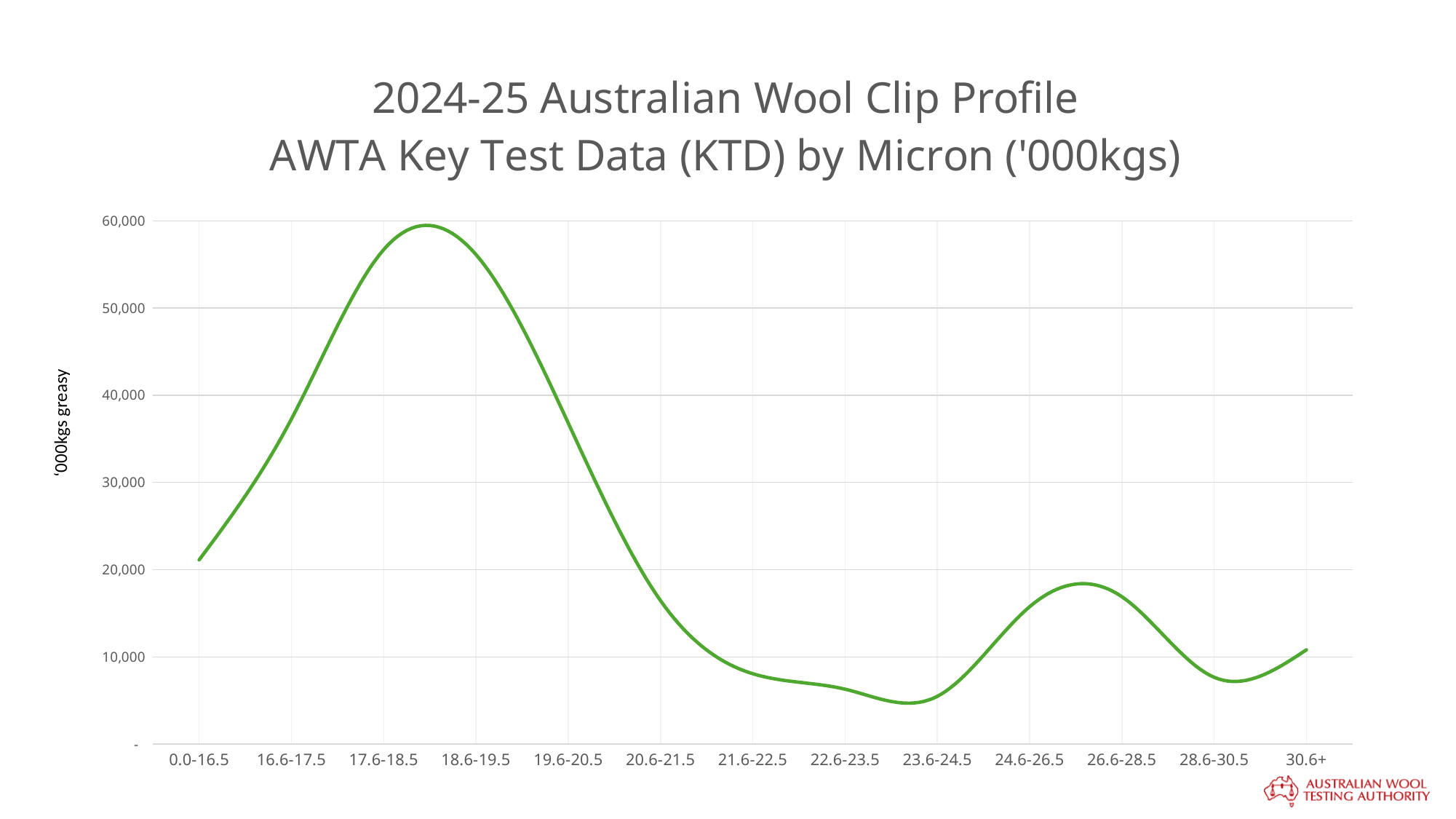
How many micron categories are shown on the x axis? 13 Is the value for 16.6-17.5 greater or less than 40,000? less What kind of chart is shown on the slide? line chart Which micron category has the lowest value? 23.6-24.5 Is the value for 28.6-30.5 greater or less than 10,000? less Do the values rise or fall from 18.6-19.5 to 23.6-24.5? fall Is the value for 16.6-17.5 greater or less than 30,000? greater Which has the larger value, 0.0-16.5 or 30.6+? 0.0-16.5 What is the label on the vertical axis? '000kgs greasy